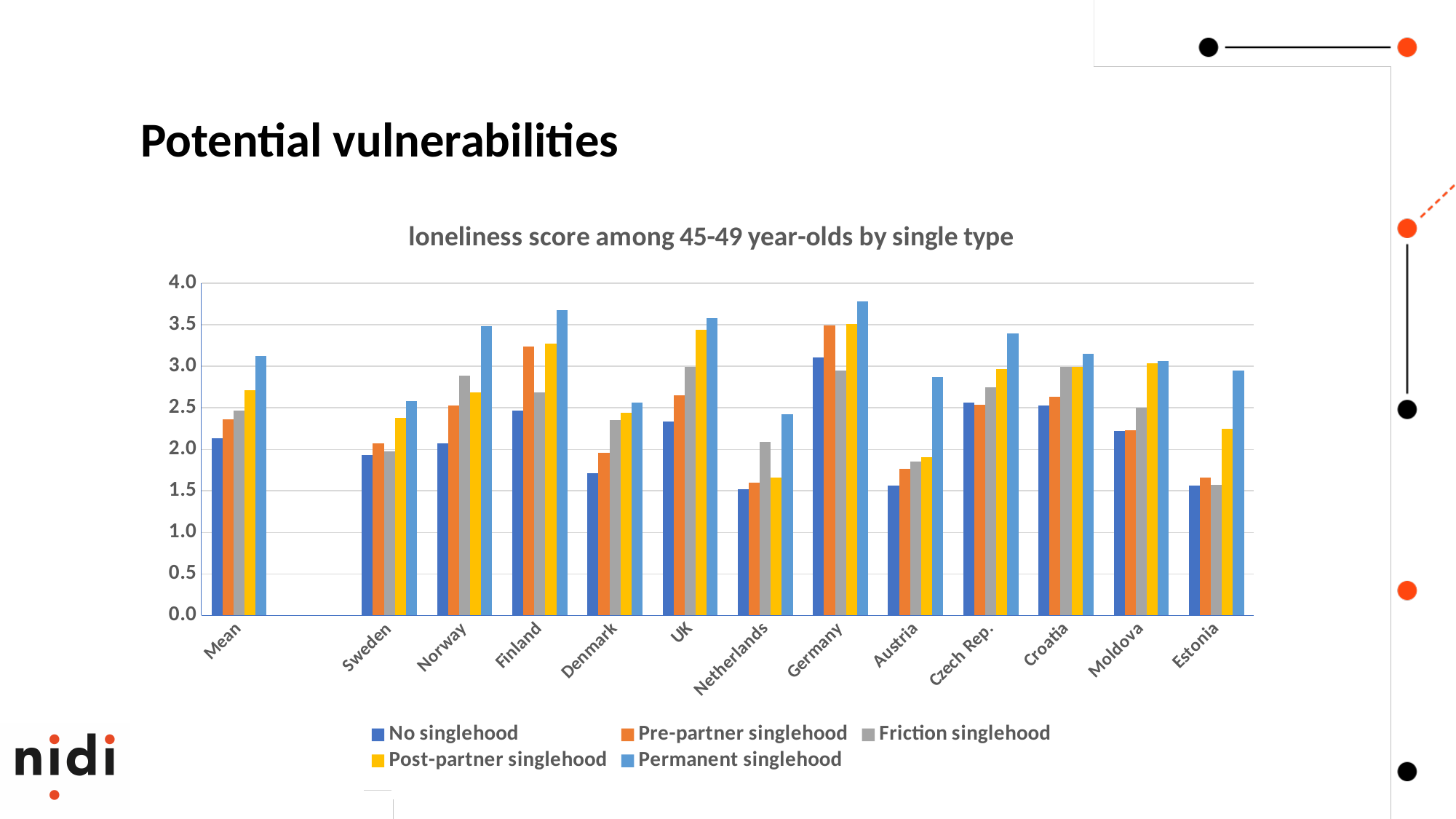
Is the Permanent singlehood value for Austria greater or less than 3.0? less What kind of chart is shown on the slide? bar chart Is the No singlehood value for Sweden greater or less than 2.0? less For Finland, which single type has the highest loneliness score? Permanent singlehood Is the Permanent singlehood value for Germany greater or less than 3.5? greater How many categories are shown on the x axis? 13 What is the title of the chart? loneliness score among 45-49 year-olds by single type Which country has the highest Permanent singlehood value? Germany Which series is shown in yellow in the legend? Post-partner singlehood How many series does the legend list? 5 For Finland, which is larger: the Pre-partner singlehood value or the Friction singlehood value? Pre-partner singlehood